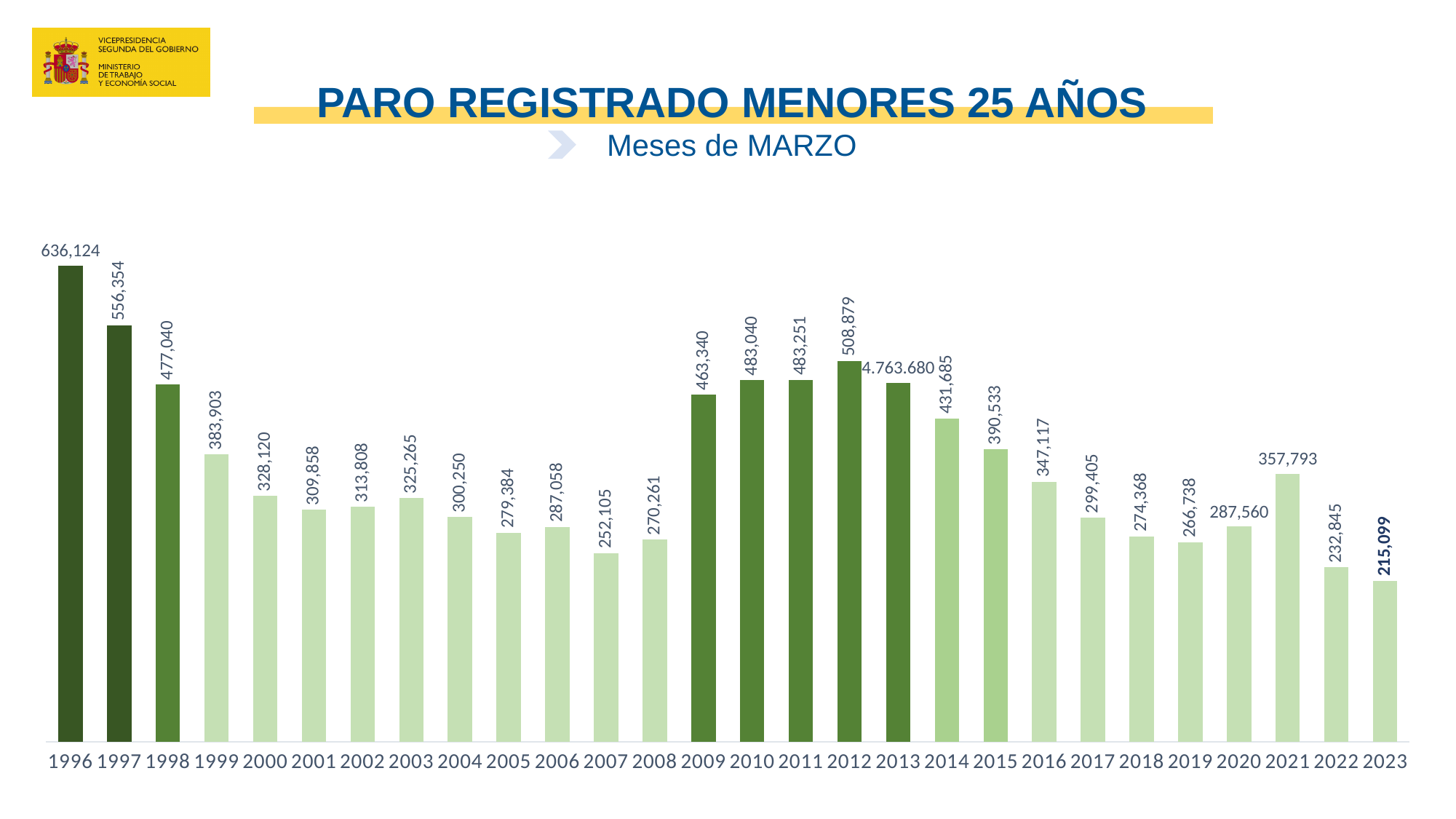
What kind of chart is shown on the slide? Bar chart Which year has the lowest value? 2023 How many years are shown on the x axis? 28 What is the value shown for 2012? 508,879 Which year has the highest value? 1996 What is the value shown for 2007? 252,105 What is the value shown for 2023? 215,099 Which is larger, the value for 2009 or the value for 2014? 2009 What is the difference between the values for 1996 and 1997? 79,770 What is the value shown for 1996? 636,124 Do the values rise or fall from 2012 to 2019? Fall What is the difference between the values for 2022 and 2023? 17,746